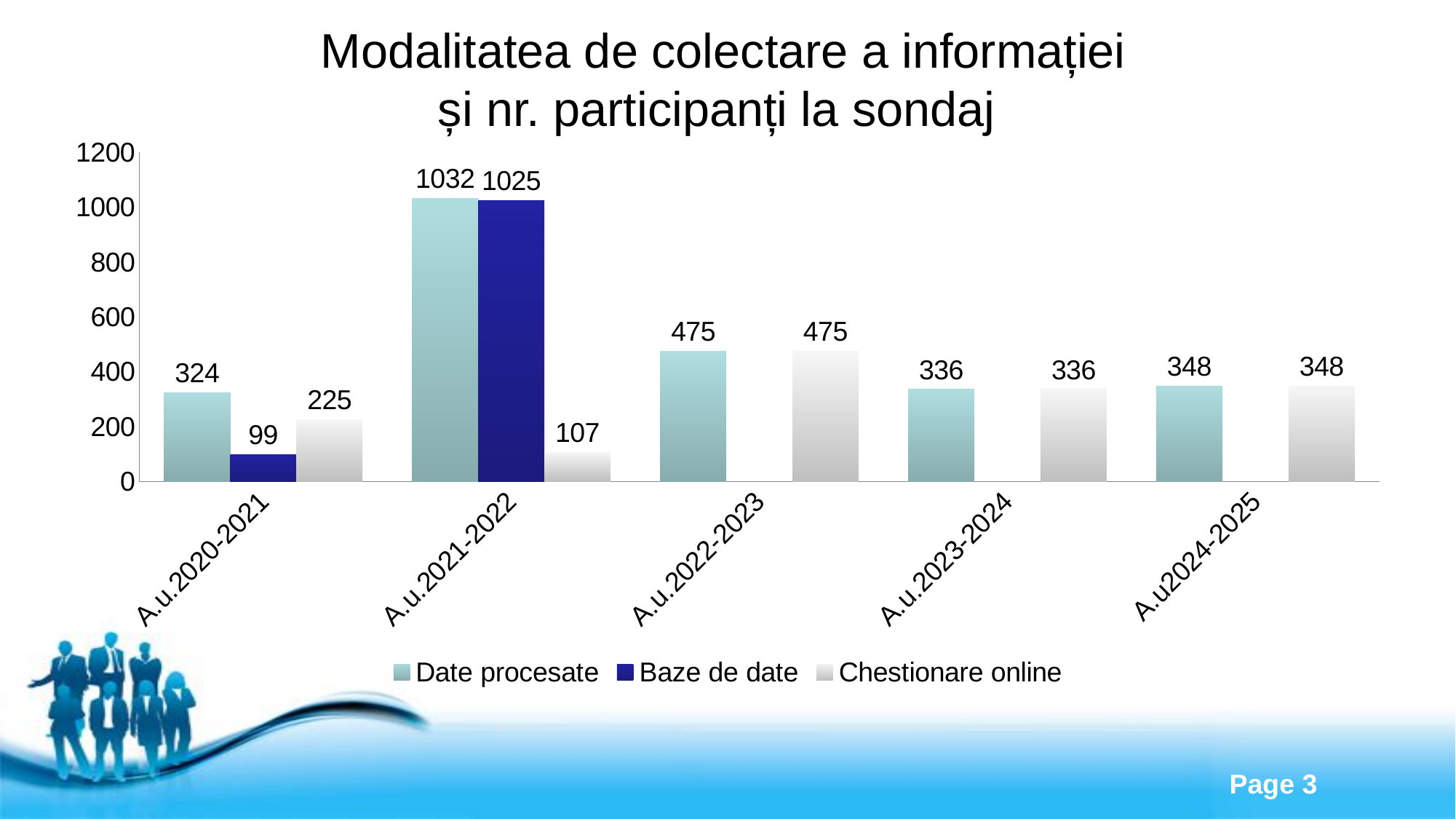
Which category has the highest value for Date procesate? A.u.2021-2022 What is the difference between Date procesate and Baze de date for A.u.2021-2022? 7 Which category has the lowest value for Chestionare online? A.u.2021-2022 What is the value of Chestionare online for A.u.2021-2022? 107 What kind of chart is shown on the slide? bar chart What is the value of Baze de date for A.u.2020-2021? 99 How many categories are shown on the x axis? 5 What is the value of Chestionare online for A.u.2022-2023? 475 What is the value of Date procesate for A.u.2021-2022? 1032 What is the difference between Date procesate for A.u.2020-2021 and Chestionare online for A.u.2020-2021? 99 How many series does the legend list? 3 Which is larger: Date procesate for A.u.2023-2024 or Date procesate for A.u2024-2025? A.u2024-2025